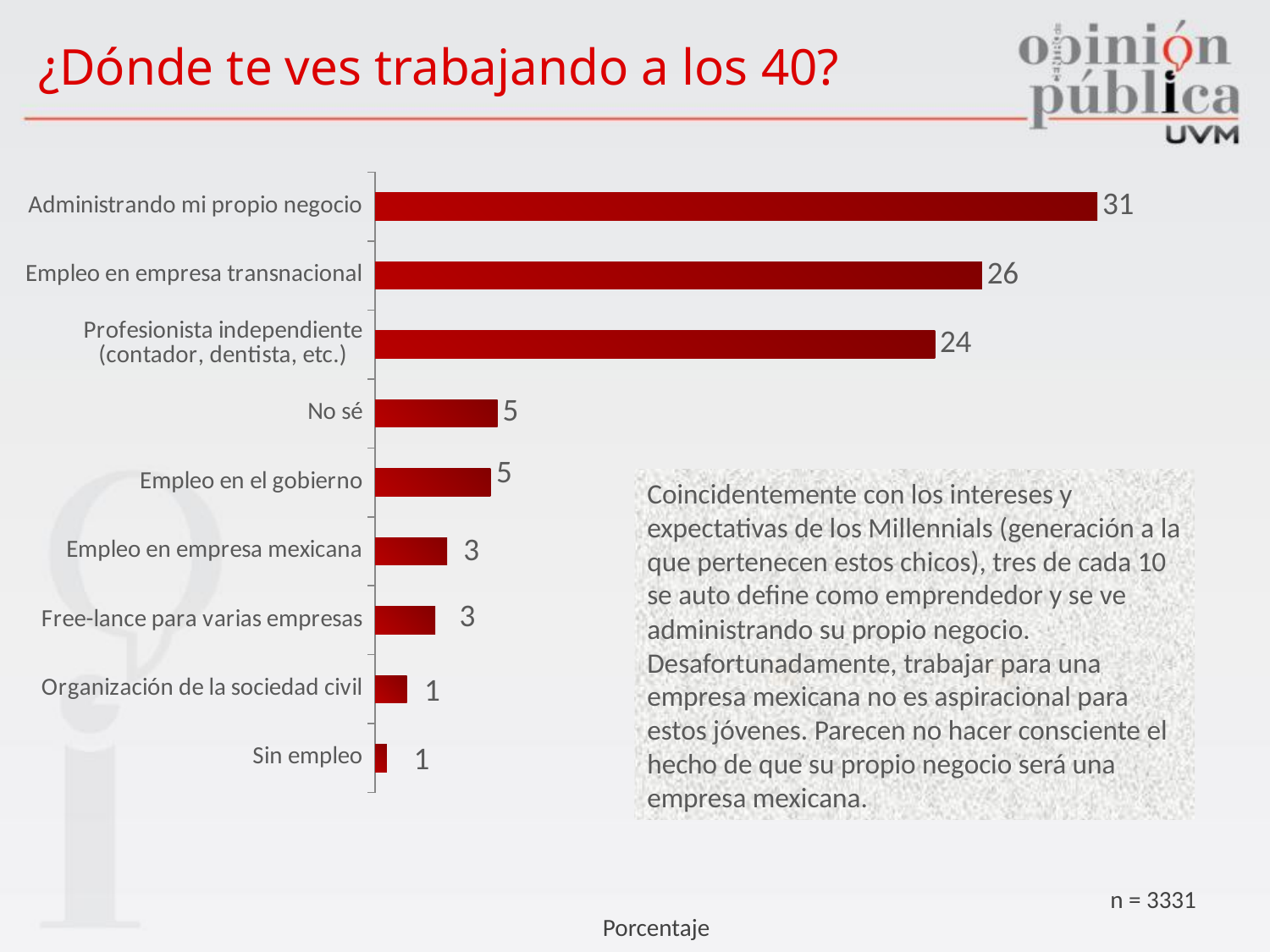
Which category has the highest value? Administrando mi propio negocio What is the value for "Administrando mi propio negocio"? 31 What is the difference between the values for "Empleo en empresa transnacional" and "Profesionista independiente (contador, dentista, etc.)"? 2 What is the difference between the values for "Administrando mi propio negocio" and "Empleo en empresa transnacional"? 5 What is the value for "Empleo en empresa transnacional"? 26 What is the value for "Profesionista independiente (contador, dentista, etc.)"? 24 What kind of chart is shown on the slide? Bar chart What is the value for "Sin empleo"? 1 What is the value for "Empleo en empresa mexicana"? 3 How many categories are shown in the chart? 9 What is the label on the horizontal axis of the chart? Porcentaje Which is larger, the value for "No sé" or the value for "Empleo en empresa mexicana"? No sé